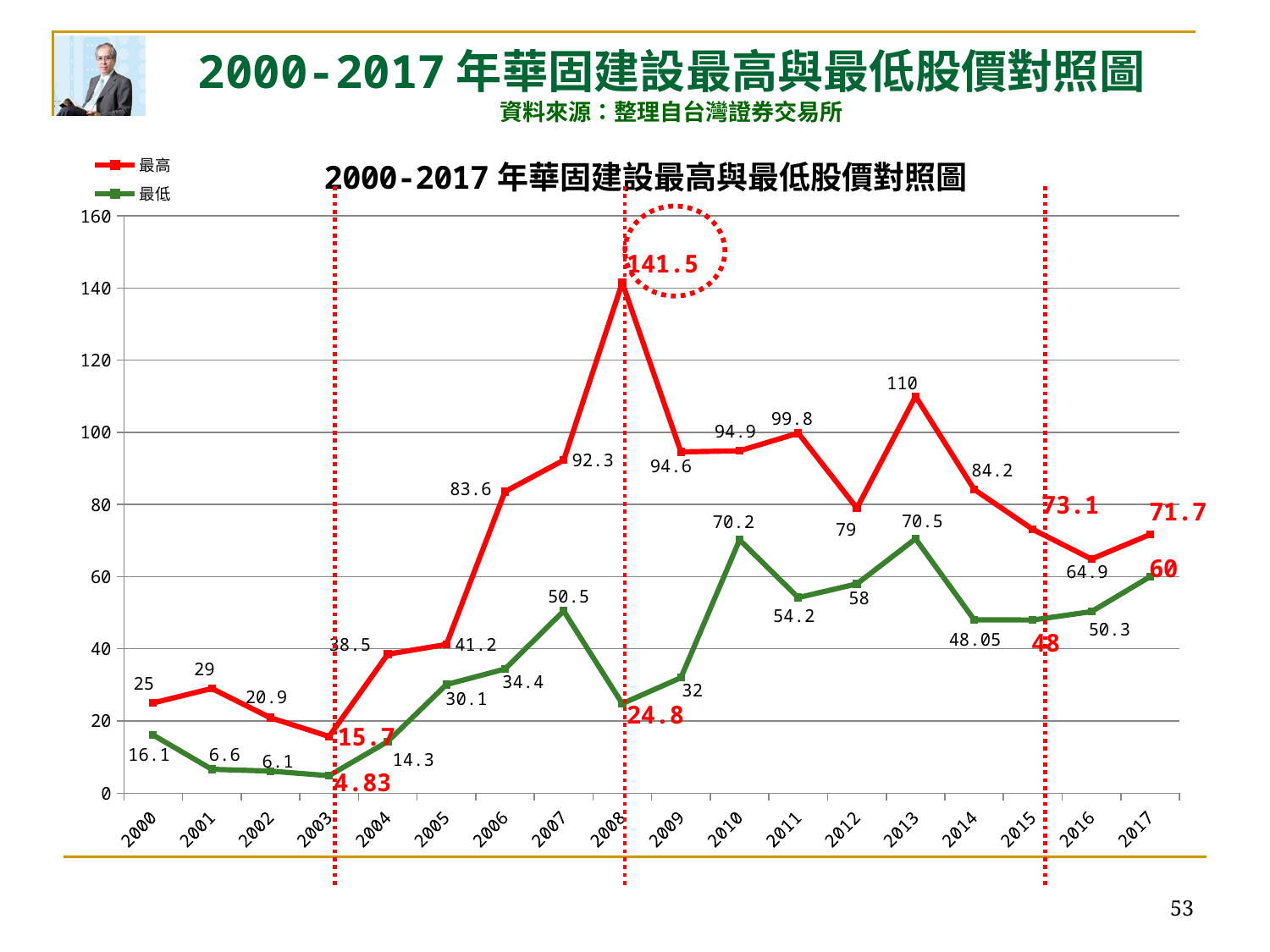
How many years are shown on the x axis? 18 What is the difference between the 最高 and 最低 values in 2008? 116.7 What is the 最高 value for 2013? 110 How many series does the legend list? 2 What kind of chart is shown on the slide? line chart In which year is the 最高 series at its highest? 2008 In which year is the 最低 series at its lowest? 2003 What is the 最高 value for 2008? 141.5 Which series is drawn in red? 最高 What is the 最低 value for 2003? 4.83 What is the 最低 value for 2017? 60 Which is larger, the 最高 value for 2010 or the 最高 value for 2011? 2011